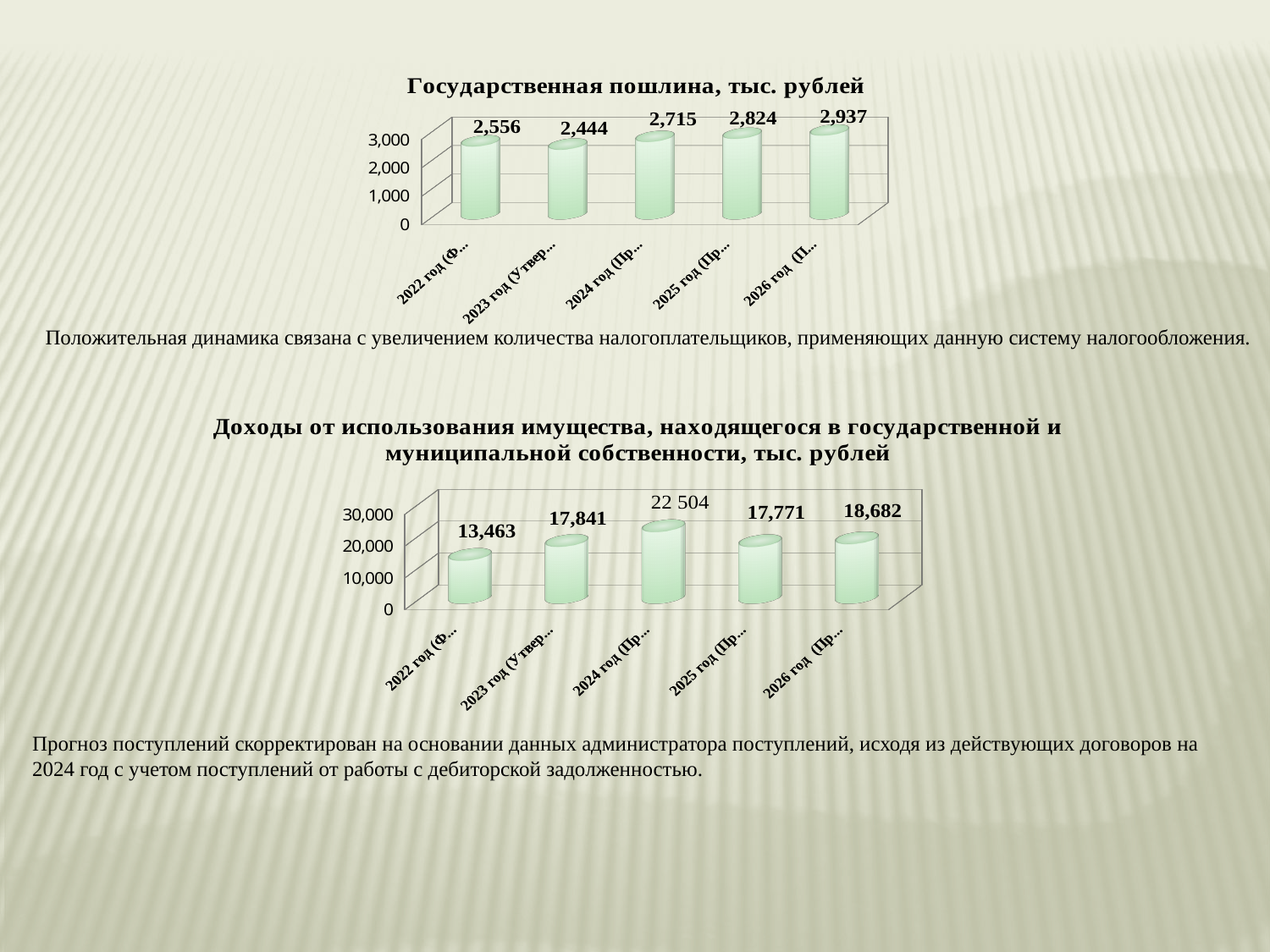
On the top chart (Государственная пошлина), what is the difference between the 2026 value and the 2022 value? 381 What type of chart is the top chart (Государственная пошлина)? Bar chart On the top chart (Государственная пошлина), what is the value for 2022? 2,556 On the bottom chart (Доходы от использования имущества), what is the value for 2024? 22 504 On the top chart (Государственная пошлина), what is the value for 2026? 2,937 On the bottom chart (Доходы от использования имущества), which year has the highest value? 2024 On the top chart (Государственная пошлина), which year has the lowest value? 2023 On the bottom chart (Доходы от использования имущества), which is larger, the value for 2025 or the value for 2026? 2026 On the top chart (Государственная пошлина), how many bars are plotted? 5 On the bottom chart (Доходы от использования имущества), is the value for 2022 greater or less than 20,000? less On the bottom chart (Доходы от использования имущества), what is the value for 2023? 17,841 On the top chart (Государственная пошлина), which year has the highest value? 2026